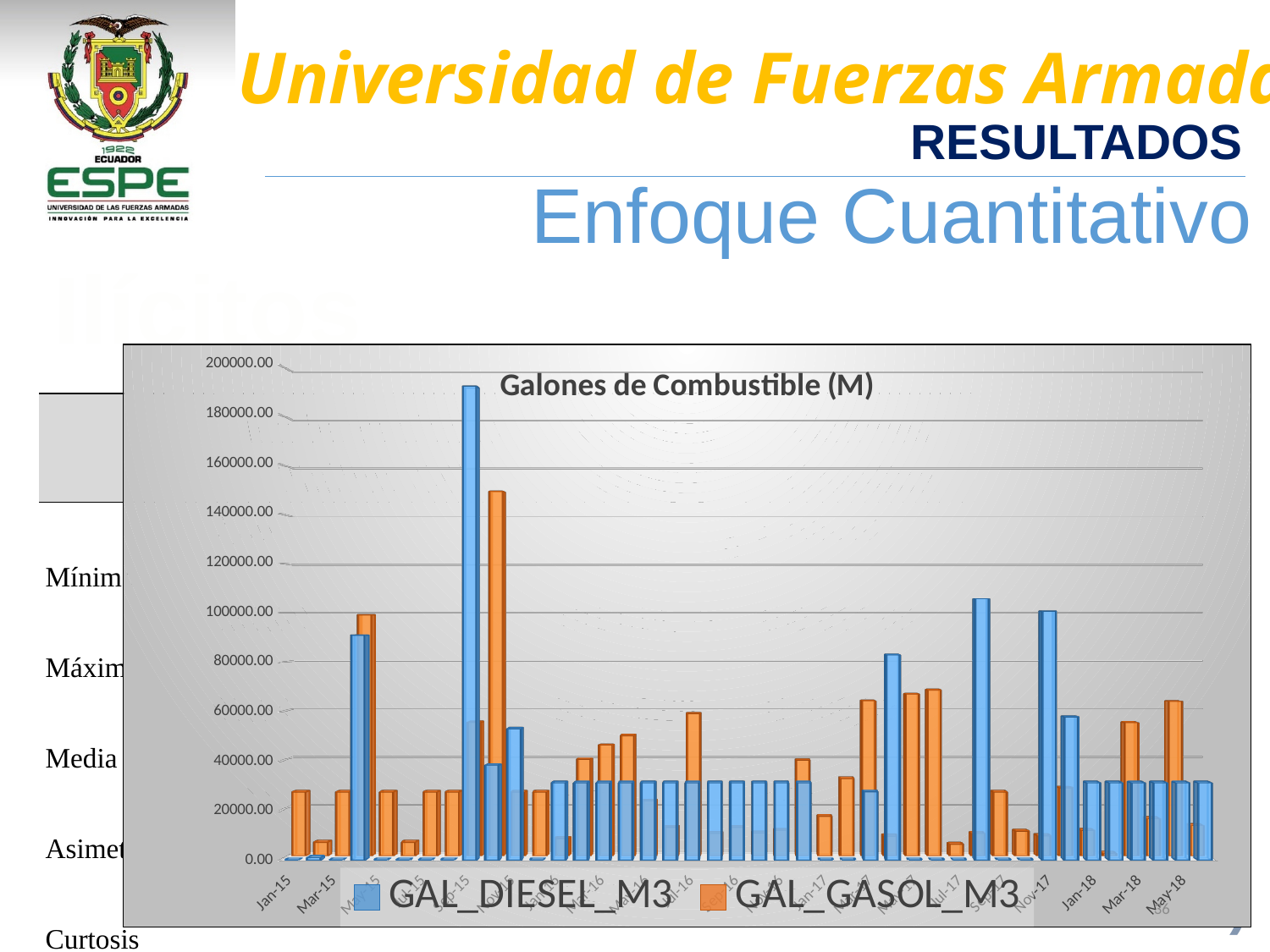
In the 'Galones de Combustible (M)' chart, is the tallest GAL_GASOL_M3 bar greater or less than 140000.00? greater In the 'Galones de Combustible (M)' chart, is the GAL_GASOL_M3 value for Mar-18 greater or less than 40000.00? greater In the 'Galones de Combustible (M)' chart, which series reaches the highest value overall? GAL_DIESEL_M3 How many series does the legend of the 'Galones de Combustible (M)' chart list? 2 In the 'Galones de Combustible (M)' chart, which series has the larger value for May-18, GAL_DIESEL_M3 or GAL_GASOL_M3? GAL_GASOL_M3 What colour represents GAL_GASOL_M3 in the 'Galones de Combustible (M)' chart? orange What kind of chart is 'Galones de Combustible (M)'? bar chart In the 'Galones de Combustible (M)' chart, is the tallest GAL_DIESEL_M3 bar greater or less than 180000.00? greater What are the two series named in the legend of the 'Galones de Combustible (M)' chart? GAL_DIESEL_M3 and GAL_GASOL_M3 In the 'Galones de Combustible (M)' chart, which series has the larger value for Jan-15, GAL_DIESEL_M3 or GAL_GASOL_M3? GAL_GASOL_M3